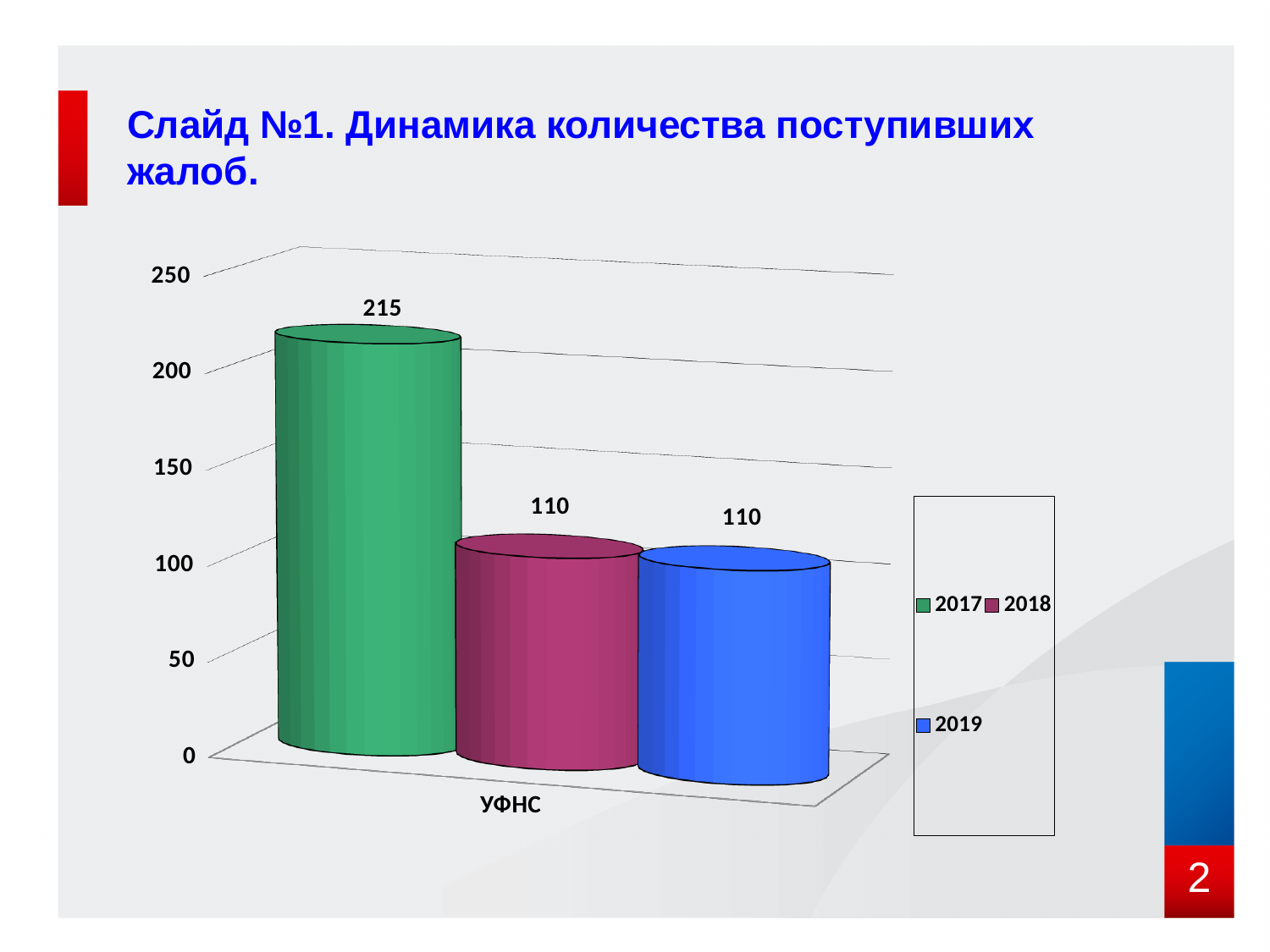
What is the category label shown on the x axis? УФНС Is the value for 2017 greater or less than 200? greater What is the value for 2018 in the УФНС category? 110 What kind of chart is shown on the slide? bar chart What colour is the bar for the 2019 series? blue How many series does the legend list? 3 What is the value for 2017 in the УФНС category? 215 Is the value for 2018 greater or less than 150? less What is the value for 2019 in the УФНС category? 110 What is the difference between the 2017 value and the 2018 value? 105 Is the value for 2017 larger or smaller than the value for 2019? larger Which series has the highest value for УФНС? 2017